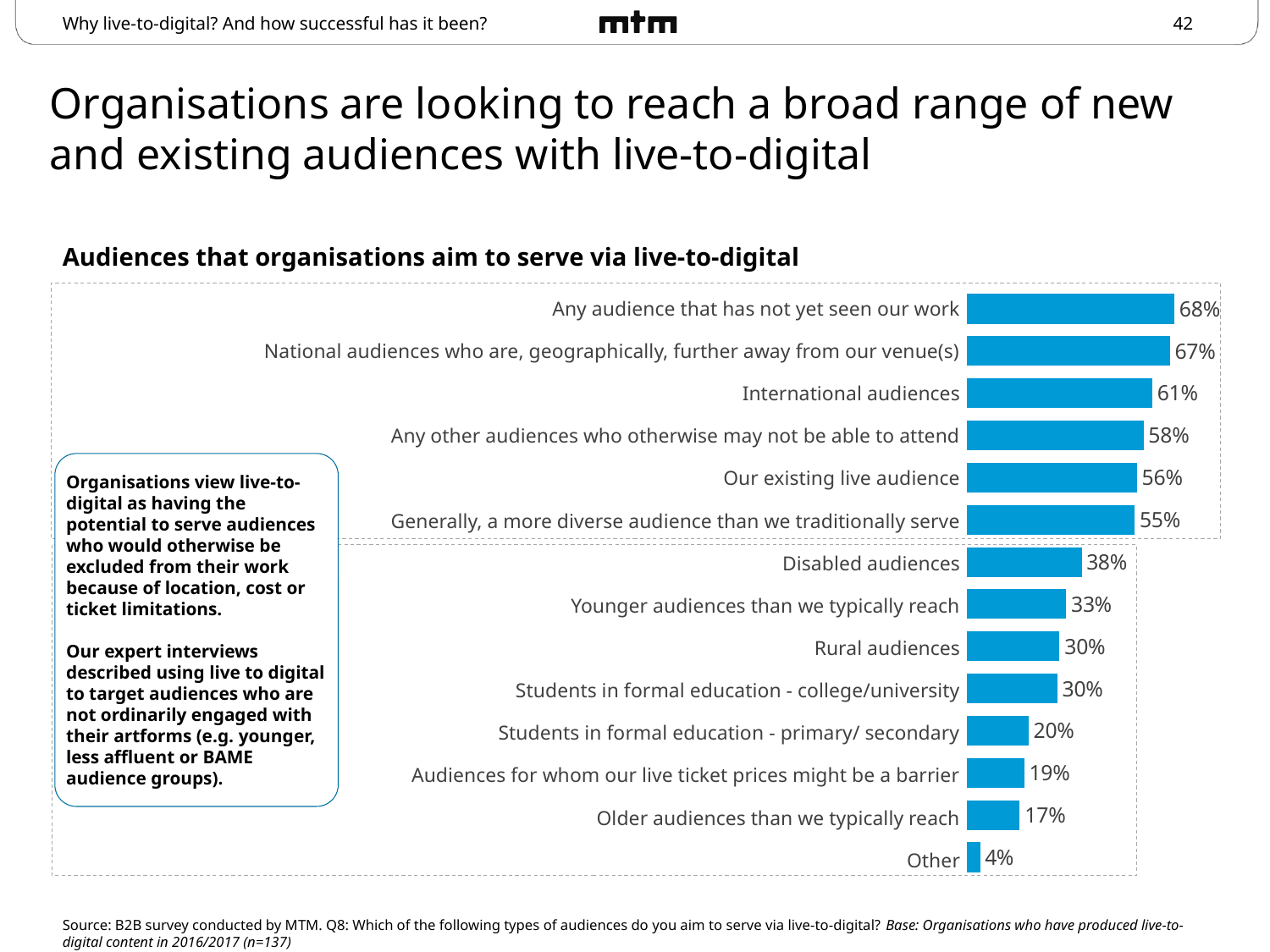
What is the value for 'Disabled audiences'? 38% What is the title of the chart? Audiences that organisations aim to serve via live-to-digital Which is larger: 'International audiences' or 'Generally, a more diverse audience than we traditionally serve'? International audiences What is the difference between 'Any audience that has not yet seen our work' and 'Our existing live audience'? 12% How many audience categories are shown in the chart? 14 Which is larger: 'Rural audiences' or 'Students in formal education - primary/ secondary'? Rural audiences Which audience category has the highest value? Any audience that has not yet seen our work What is the value for 'Older audiences than we typically reach'? 17% What is the difference between 'Disabled audiences' and 'Younger audiences than we typically reach'? 5% What type of chart is shown on the slide? Bar chart Which audience category has the lowest value? Other What percentage of organisations aim to serve international audiences via live-to-digital? 61%